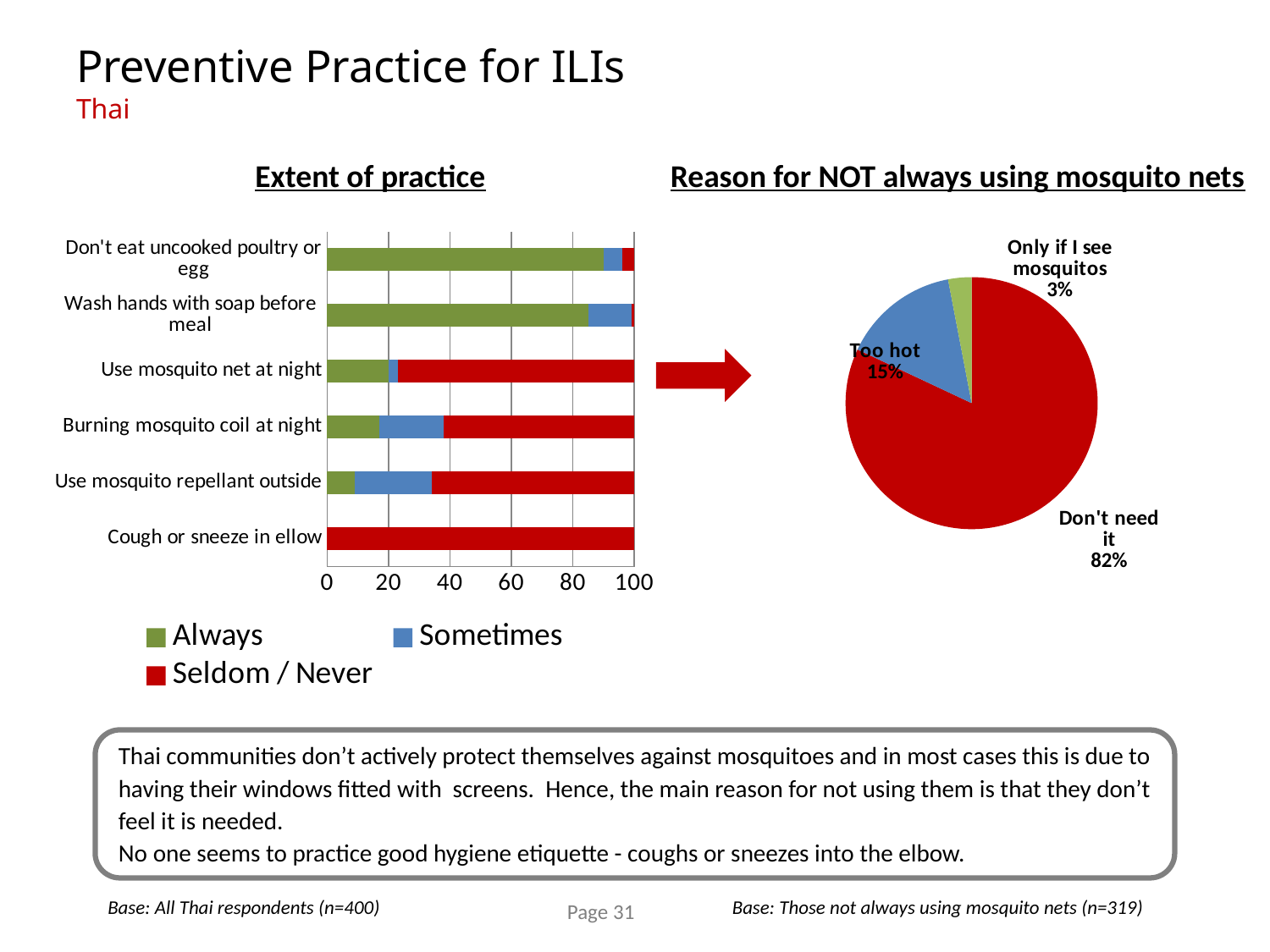
In the "Reason for NOT always using mosquito nets" chart, what is the difference between the "Don't need it" and "Too hot" shares? 67% How many categories are shown on the "Extent of practice" chart? 6 How many series does the legend of the "Extent of practice" chart list? 3 In the "Reason for NOT always using mosquito nets" chart, what share is "Too hot"? 15% In the "Extent of practice" chart, which category has the largest "Seldom / Never" segment? Cough or sneeze in ellow In the "Extent of practice" chart, is the "Always" value for "Don't eat uncooked poultry or egg" greater or less than 80? greater In the "Reason for NOT always using mosquito nets" chart, which is larger: "Too hot" or "Only if I see mosquitos"? Too hot In the "Extent of practice" chart, is the "Always" value for "Use mosquito repellant outside" greater or less than 20? less In the "Reason for NOT always using mosquito nets" chart, which reason has the smallest share? Only if I see mosquitos What kind of chart is the "Reason for NOT always using mosquito nets" chart? pie chart In the "Reason for NOT always using mosquito nets" chart, what share is "Don't need it"? 82% What kind of chart is the "Extent of practice" chart? bar chart